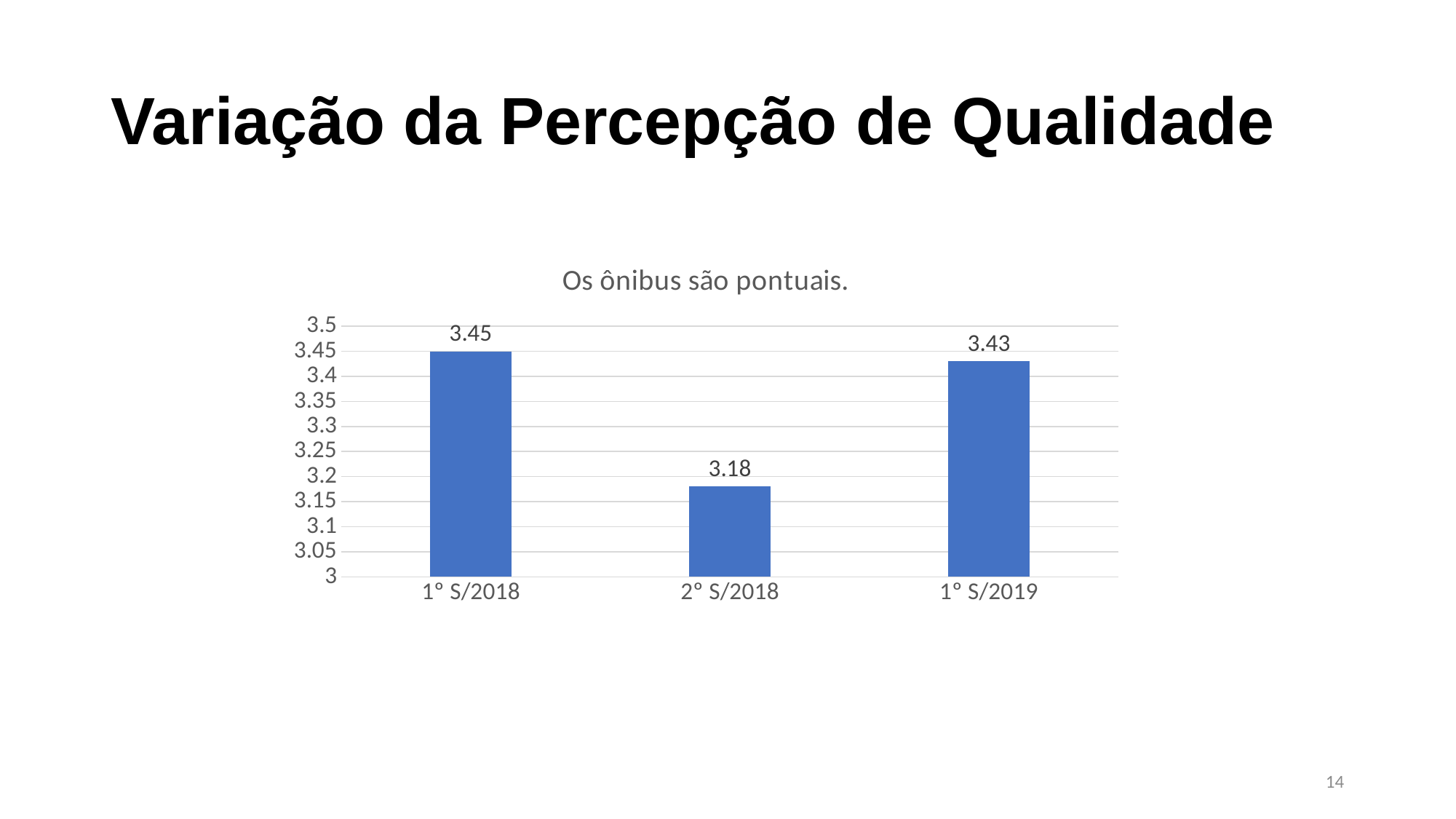
What is the difference between the values for 1° S/2018 and 2° S/2018? 0.27 Which is larger, the value for 2° S/2018 or the value for 1° S/2019? 1° S/2019 Is the value for 2° S/2018 greater or less than 3.3? less What is the value for 2° S/2018? 3.18 What is the title of the chart? Os ônibus são pontuais. How many categories are shown on the x axis? 3 Which category has the lowest value? 2° S/2018 What is the value for 1° S/2018? 3.45 What is the difference between the values for 1° S/2019 and 2° S/2018? 0.25 What is the value for 1° S/2019? 3.43 What kind of chart is shown on the slide? bar chart Which category has the highest value? 1° S/2018